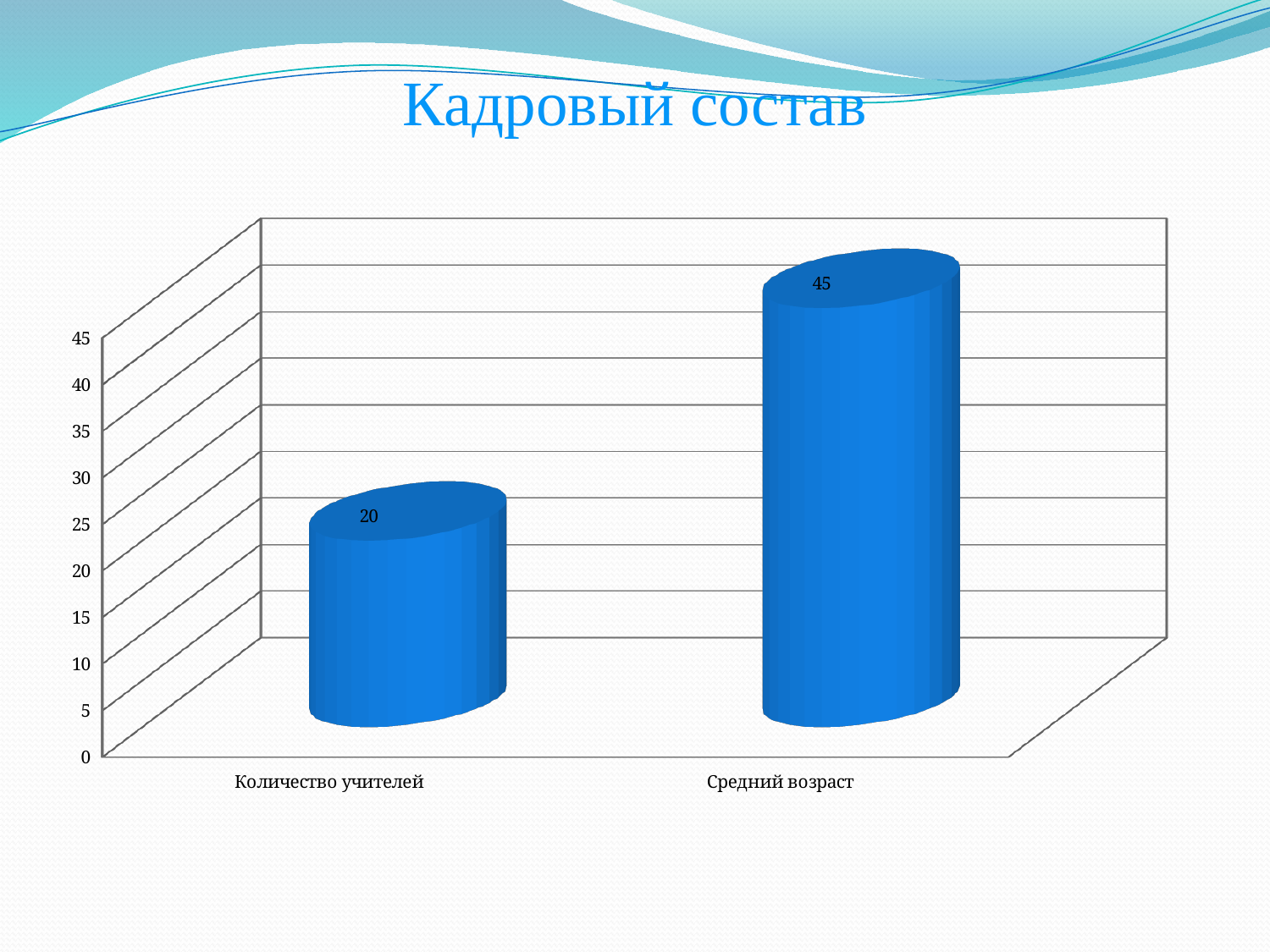
Which category has the lowest value? Количество учителей What is the title of the slide? Кадровый состав What kind of chart is shown on the slide? bar chart What is the value for Количество учителей? 20 What colour are the bars in the chart? blue Is the value for Количество учителей greater or less than 30? less Is the value for Средний возраст greater or less than 40? greater What is the difference between the values for Средний возраст and Количество учителей? 25 How many categories are shown on the chart? 2 What is the value for Средний возраст? 45 Which category has the highest value? Средний возраст Which is larger, the value for Количество учителей or the value for Средний возраст? Средний возраст